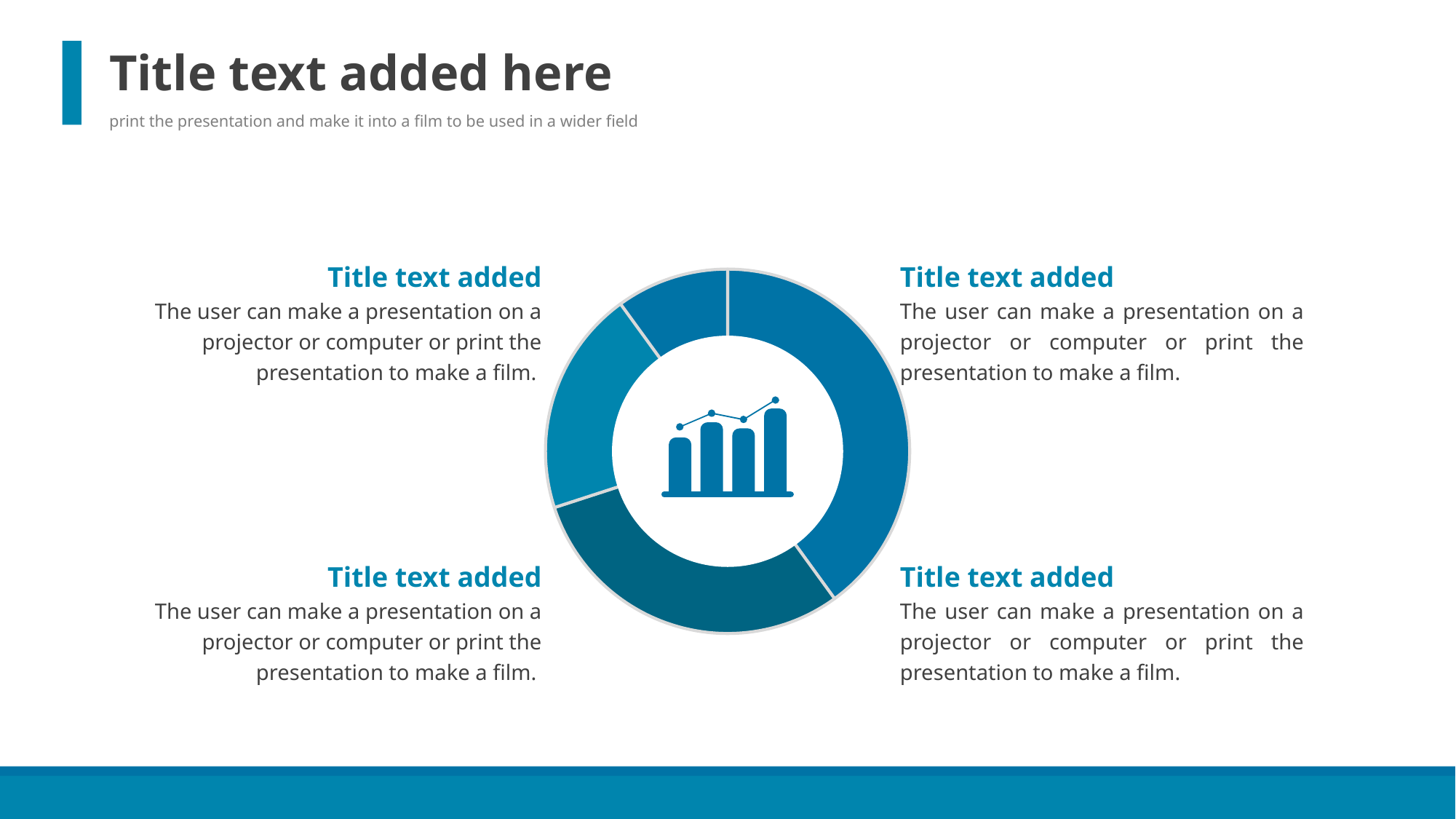
What kind of chart is shown in the centre of the slide? A donut (pie) chart Which segment of the donut chart is the largest? The dark blue segment on the right Is the segment on the right of the donut chart larger or smaller than the segment at the top left? Larger What icon is shown in the centre of the donut chart? A bar chart with a line graph Which segment of the donut chart is the smallest? The small segment at the top left How many segments does the donut chart have? 4 Does the donut chart display any data labels or values on its segments? No